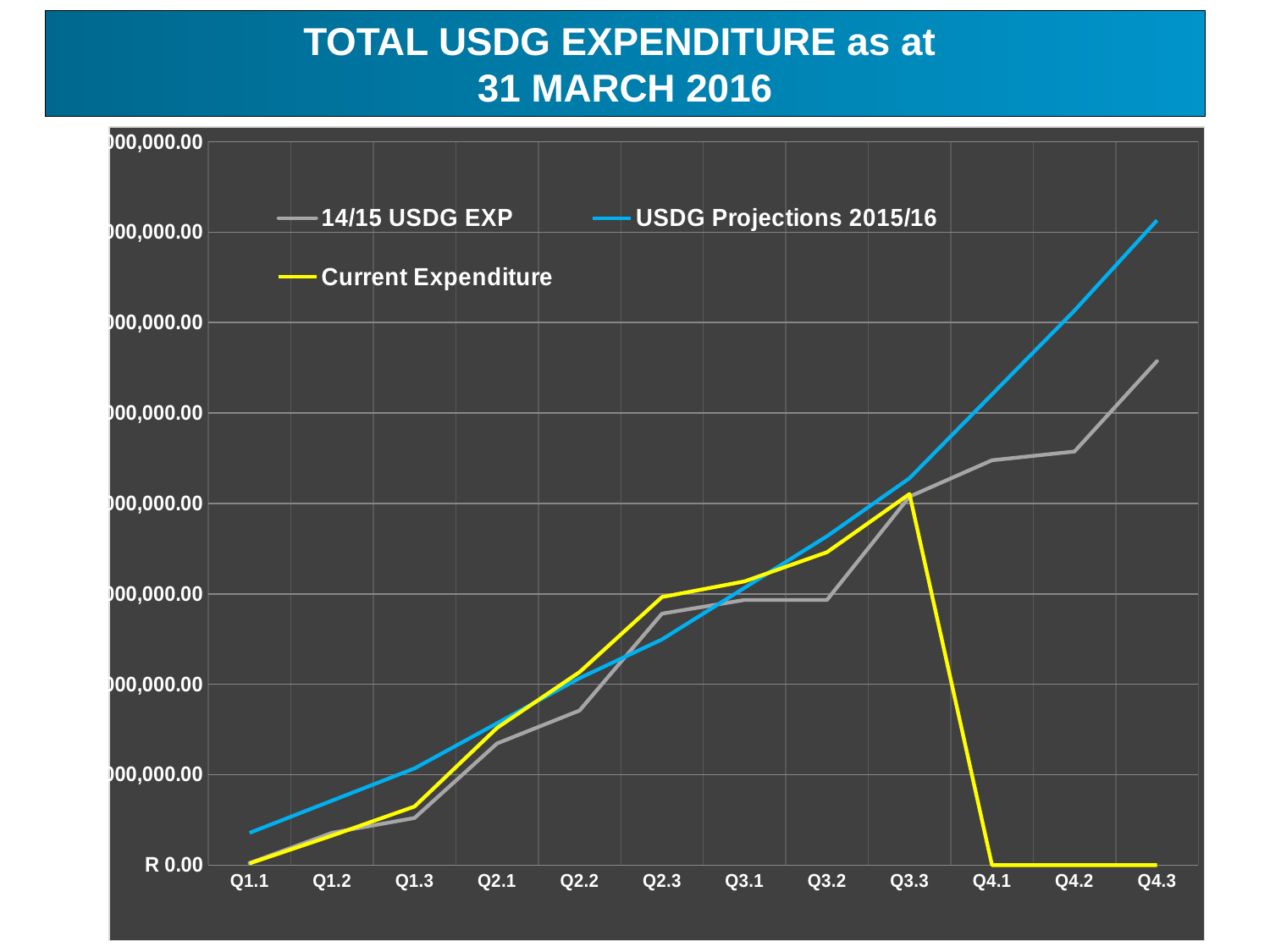
What kind of chart is shown on the slide? line chart How many series does the legend list? 3 At which category does the Current Expenditure line reach its highest value? Q3.3 At Q4.3, which is higher: USDG Projections 2015/16 or 14/15 USDG EXP? USDG Projections 2015/16 What is the Current Expenditure value at Q4.1? R 0.00 Does the USDG Projections 2015/16 line rise or fall from Q1.1 to Q4.3? rise What colour is the Current Expenditure line? yellow What is the Current Expenditure value at Q4.3? R 0.00 At Q3.2, which is higher: Current Expenditure or 14/15 USDG EXP? Current Expenditure Which series has the highest value at Q4.3? USDG Projections 2015/16 What is the title of the chart? TOTAL USDG EXPENDITURE as at 31 MARCH 2016 How many categories are shown on the x axis? 12